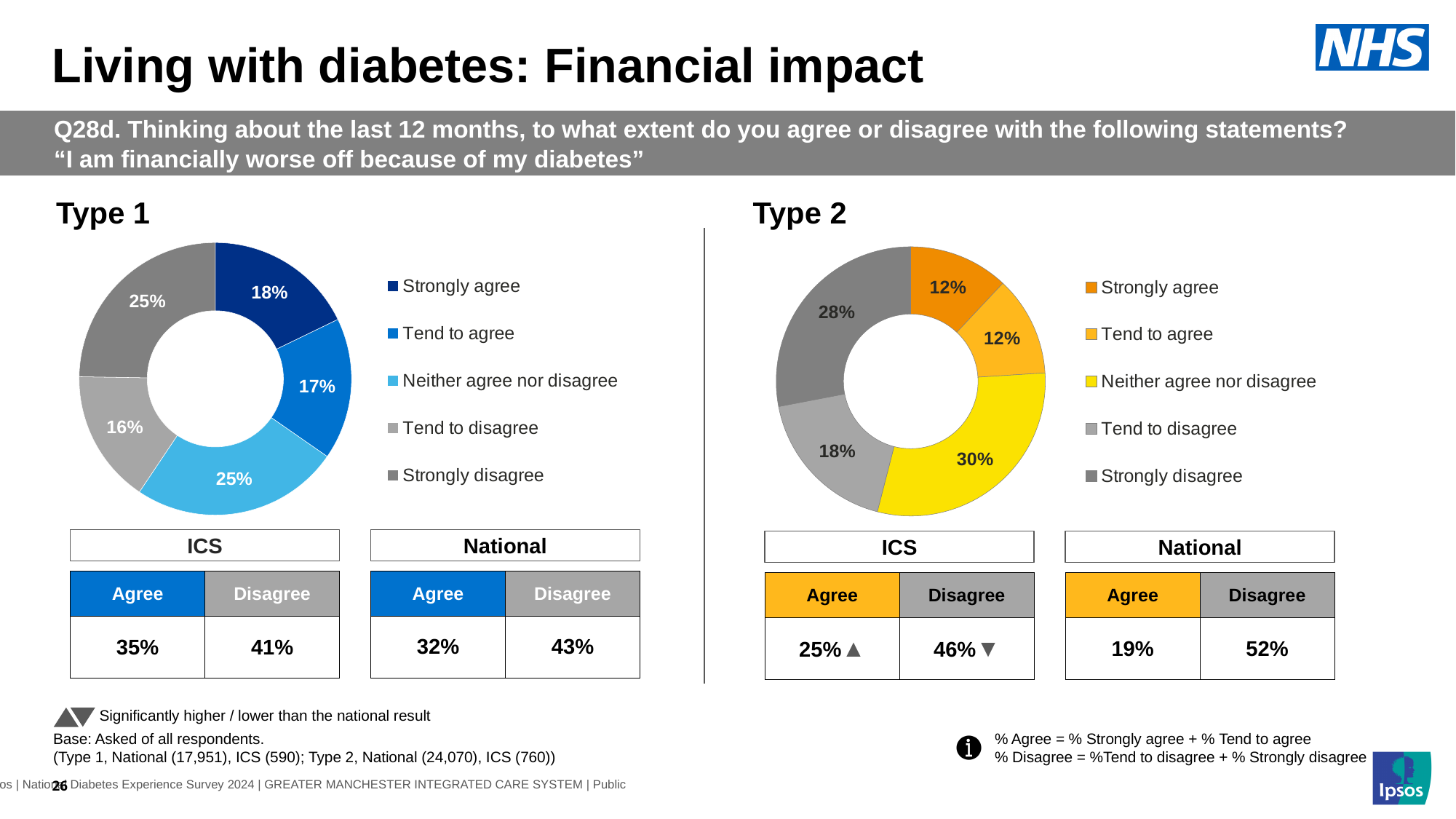
In the Type 2 chart, what colour represents 'Neither agree nor disagree'? Yellow In the Type 2 chart, what percentage of respondents neither agree nor disagree? 30% What type of chart is used for the Type 2 results? Donut (pie) chart How many response categories does the Type 1 chart show? 5 In the Type 1 chart, what percentage of respondents tend to disagree? 16% In the Type 2 chart, which is larger: the 'Strongly disagree' share or the 'Strongly agree' share? Strongly disagree In the Type 1 chart, what percentage of respondents strongly agree? 18% In the Type 1 chart, which response category has the smallest share? Tend to disagree In the Type 2 chart, what is the difference between the 'Strongly disagree' share and the 'Tend to disagree' share? 10% In the Type 1 chart, what is the difference between the 'Neither agree nor disagree' share and the 'Tend to agree' share? 8% In the Type 2 chart, what percentage of respondents strongly disagree? 28% In the Type 2 chart, which response category has the largest share? Neither agree nor disagree